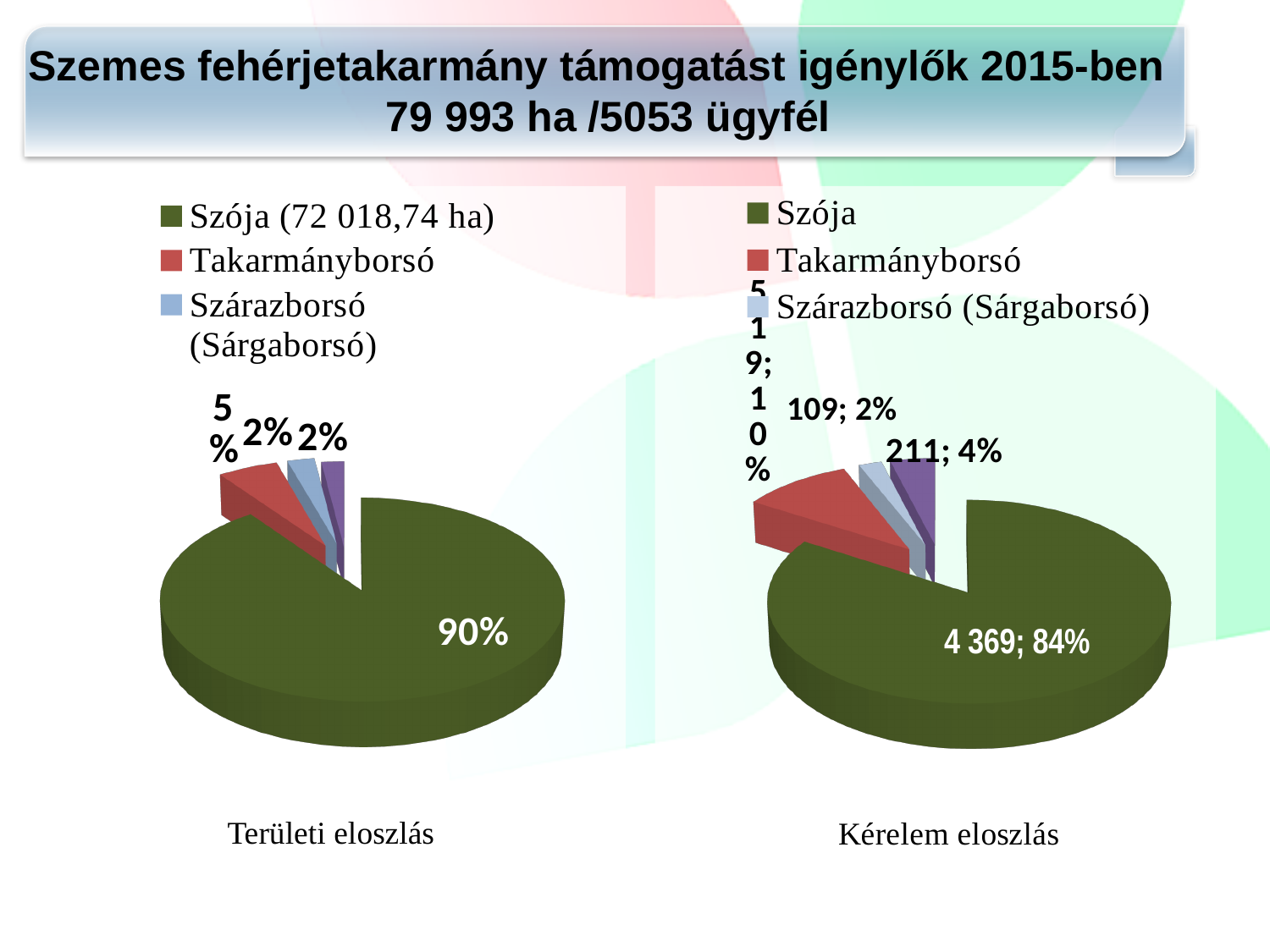
In the 'Kérelem eloszlás' chart on the right, what value is shown for Szója? 4 369 In the 'Kérelem eloszlás' chart on the right, what value is shown for Szárazborsó (Sárgaborsó)? 109 In the 'Kérelem eloszlás' chart on the right, what value is shown for Takarmányborsó? 519 In the 'Kérelem eloszlás' chart on the right, which is larger, the value for Takarmányborsó or for Szárazborsó (Sárgaborsó)? Takarmányborsó In the 'Kérelem eloszlás' chart on the right, what share of the pie does Szója have? 84% In the 'Kérelem eloszlás' chart on the right, which category has the largest slice? Szója What kind of chart is the 'Területi eloszlás' chart on the left? pie chart In the 'Kérelem eloszlás' chart on the right, what is the difference between the values for Szója and Takarmányborsó? 3 850 How many entries does the legend of the 'Kérelem eloszlás' chart on the right list? 3 In the 'Területi eloszlás' chart on the left, what share of the pie does Szója have? 90% In the 'Területi eloszlás' chart on the left, what percentage is shown for Takarmányborsó? 5% In the 'Területi eloszlás' chart on the left, what area in hectares is given for Szója in the legend? 72 018,74 ha